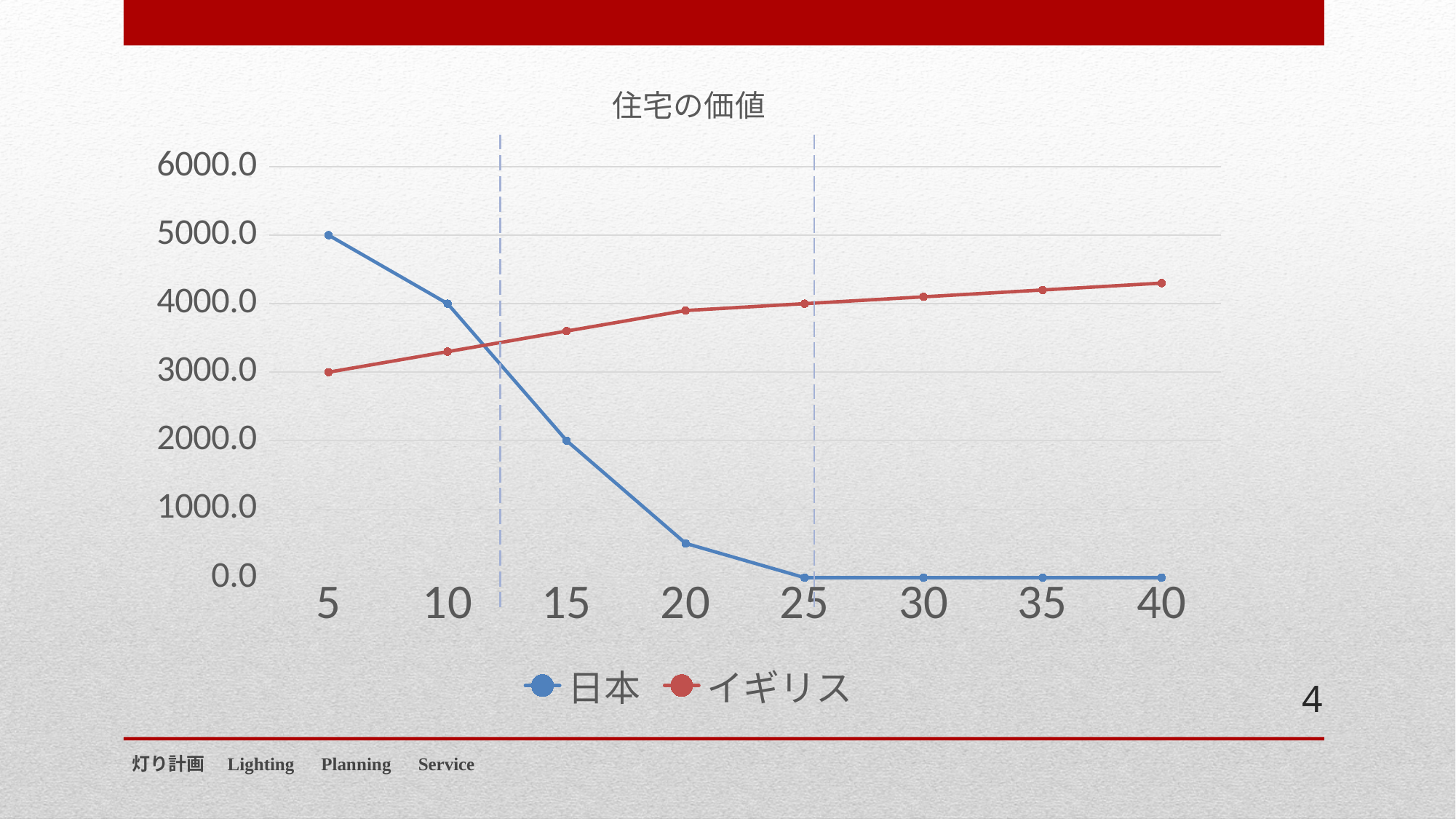
Is the value for イギリス at 40 greater or less than 4000? greater How many series does the legend list? 2 What is the value for 日本 at 15? 2000.0 What is the title of the chart? 住宅の価値 What is the value for イギリス at 5? 3000.0 Which series has the larger value at 40, 日本 or イギリス? イギリス What is the value for 日本 at 40? 0.0 How many points are plotted along the x axis for each series? 8 Is the value for 日本 at 20 greater or less than 1000? less What kind of chart is shown on the slide? line chart Do the values for 日本 rise or fall as the x axis goes from 5 to 25? fall What is the value for 日本 at 5? 5000.0